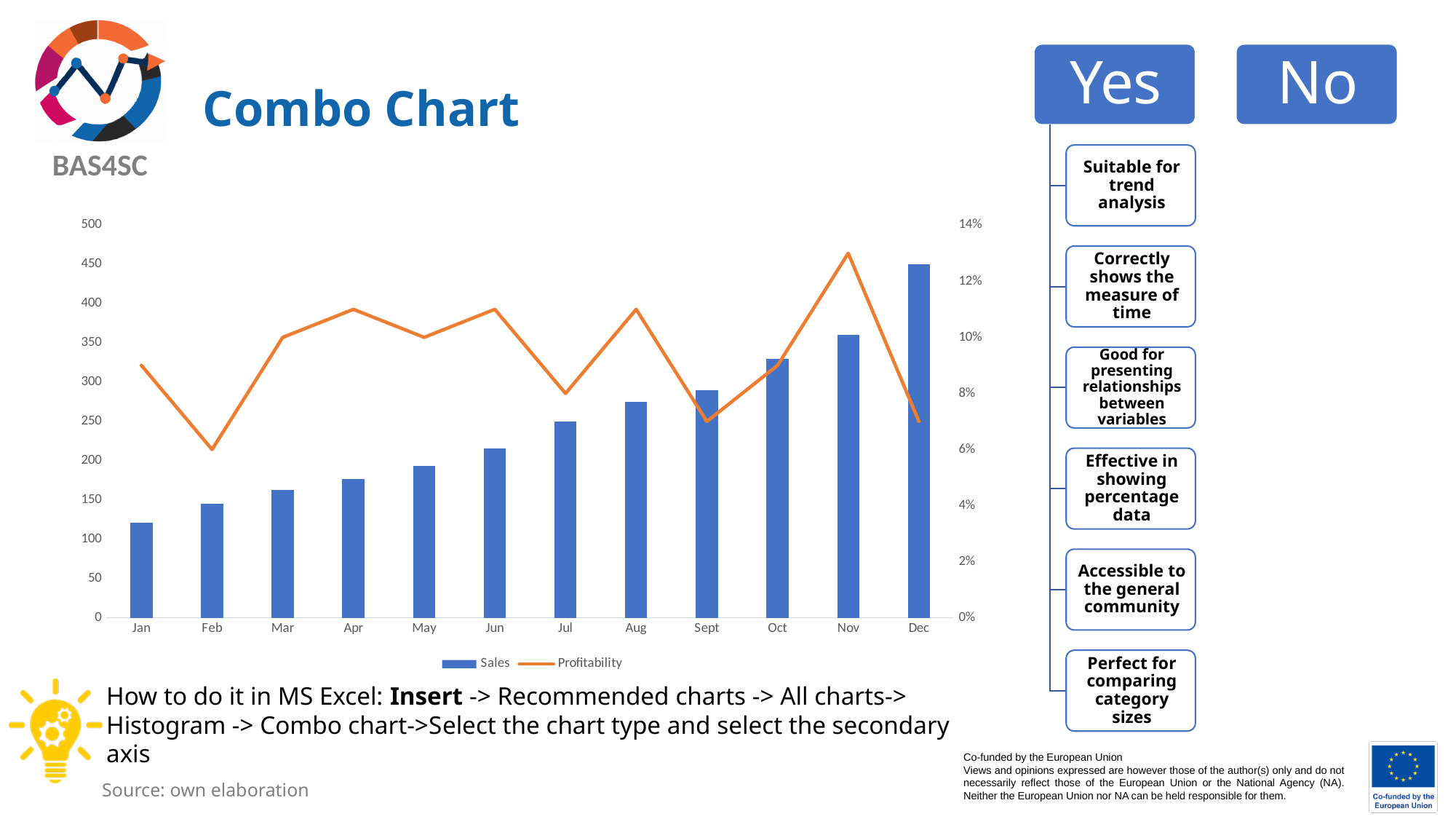
Which month has higher Sales, Sept or Oct? Oct In which month does the Profitability line reach its highest point? Nov Which month has the lowest Sales bar? Jan How many months are shown on the x axis of the chart? 12 In which month does the Profitability line reach its lowest point? Feb Do the Sales bars rise or fall from Jan to Dec? rise What kind of chart is shown on the slide? combo chart (bar and line) Is the Sales value for Jan greater or less than 150? less Which month has the highest Sales bar? Dec Is the Profitability value for Nov greater or less than 12%? greater Is the Sales value for Dec greater or less than 400? greater How many series does the chart legend list? 2